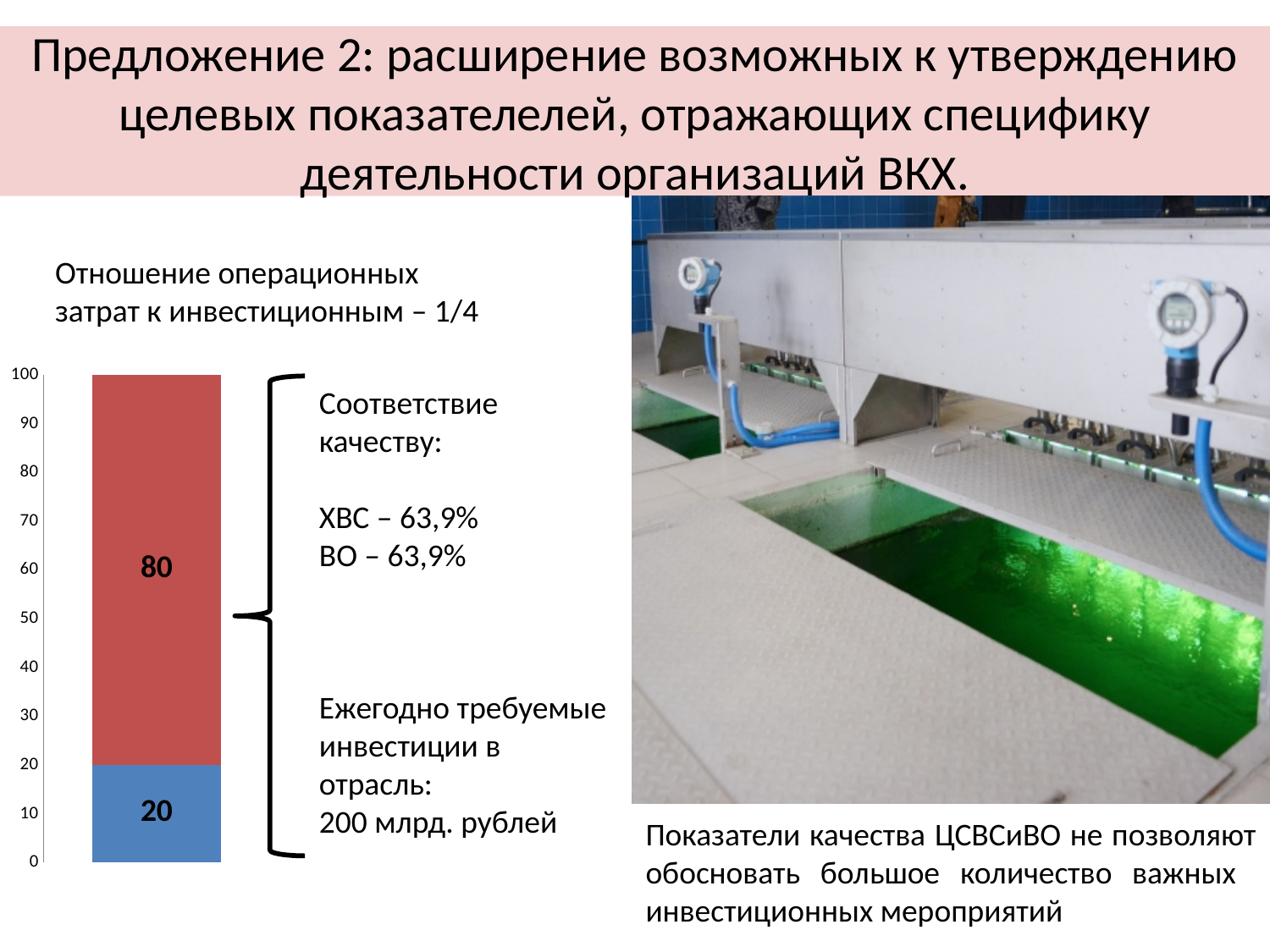
What is the difference between the red segment value and the blue segment value? 60 Which segment of the stacked bar is larger, the red one or the blue one? the red one How many segments does the stacked bar contain? 2 Is the value of the blue segment greater or less than 50? less What is the total of the stacked bar? 100 What kind of chart is shown on the slide? stacked bar chart What is the maximum value shown on the vertical axis of the chart? 100 What value is printed on the blue segment of the stacked bar? 20 Which segment of the stacked bar has the smallest value? the blue segment (20) What colour is the bottom segment of the stacked bar? blue What value is printed on the red segment of the stacked bar? 80 Which segment of the stacked bar has the largest value? the red segment (80)